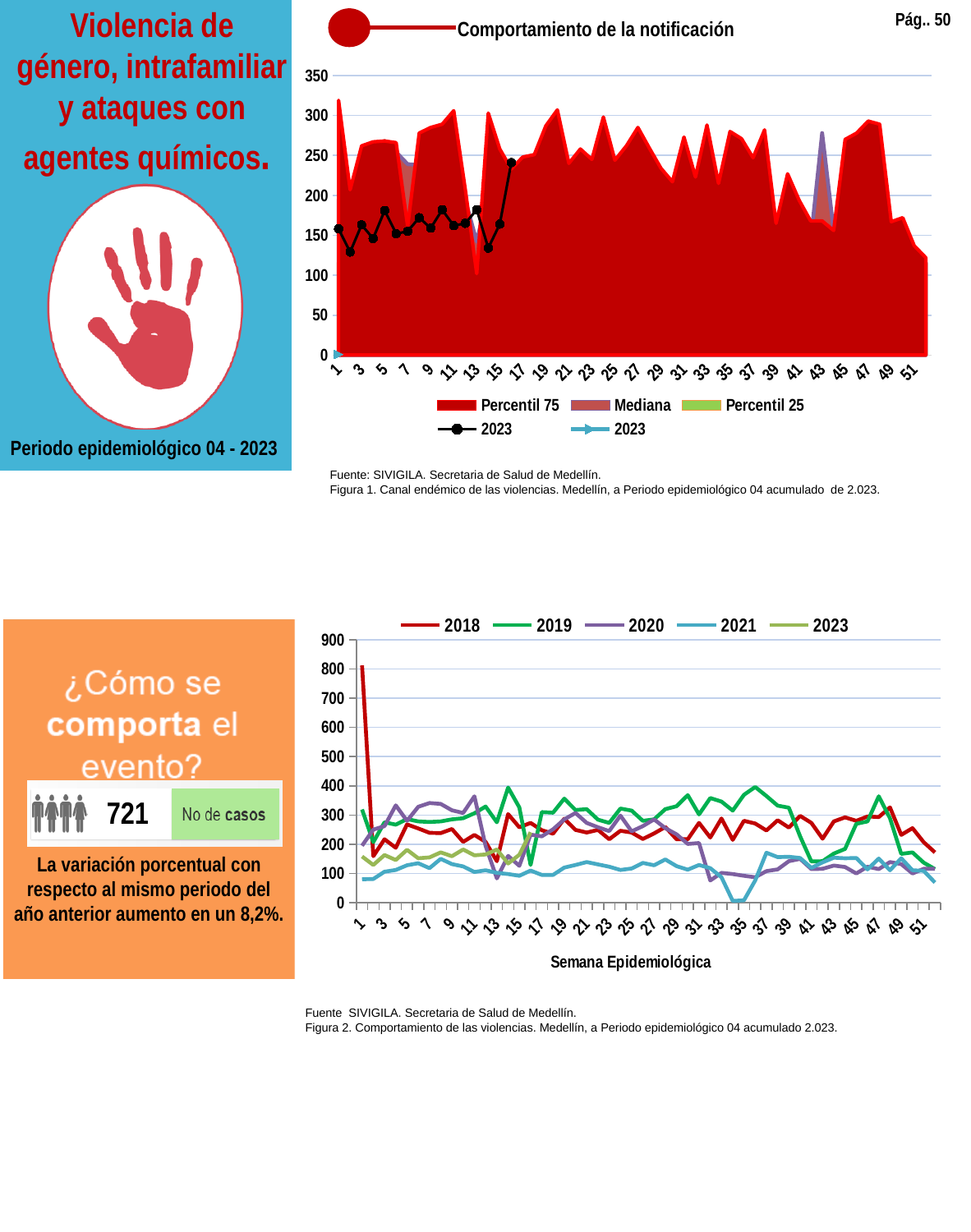
In the top chart, is the value of the black 2023 line at week 1 greater or less than 200? less What is the x-axis title of the bottom chart? Semana Epidemiológica In the bottom chart, at week 1, which series has the larger value, 2018 or 2021? 2018 In the bottom chart, which series has the highest value at week 1? 2018 In the top chart, how many entries does the legend list? 5 In the bottom chart, is the value of the 2021 series at week 35 greater or less than 100? less What kind of chart is the bottom chart with the x-axis "Semana Epidemiológica"? line chart In the bottom chart, is the value of the 2018 series at week 1 greater or less than 700? greater What is the title of the top chart? Comportamiento de la notificación In the bottom chart, how many series does the legend list? 5 What kind of chart is the top chart titled "Comportamiento de la notificación"? area chart